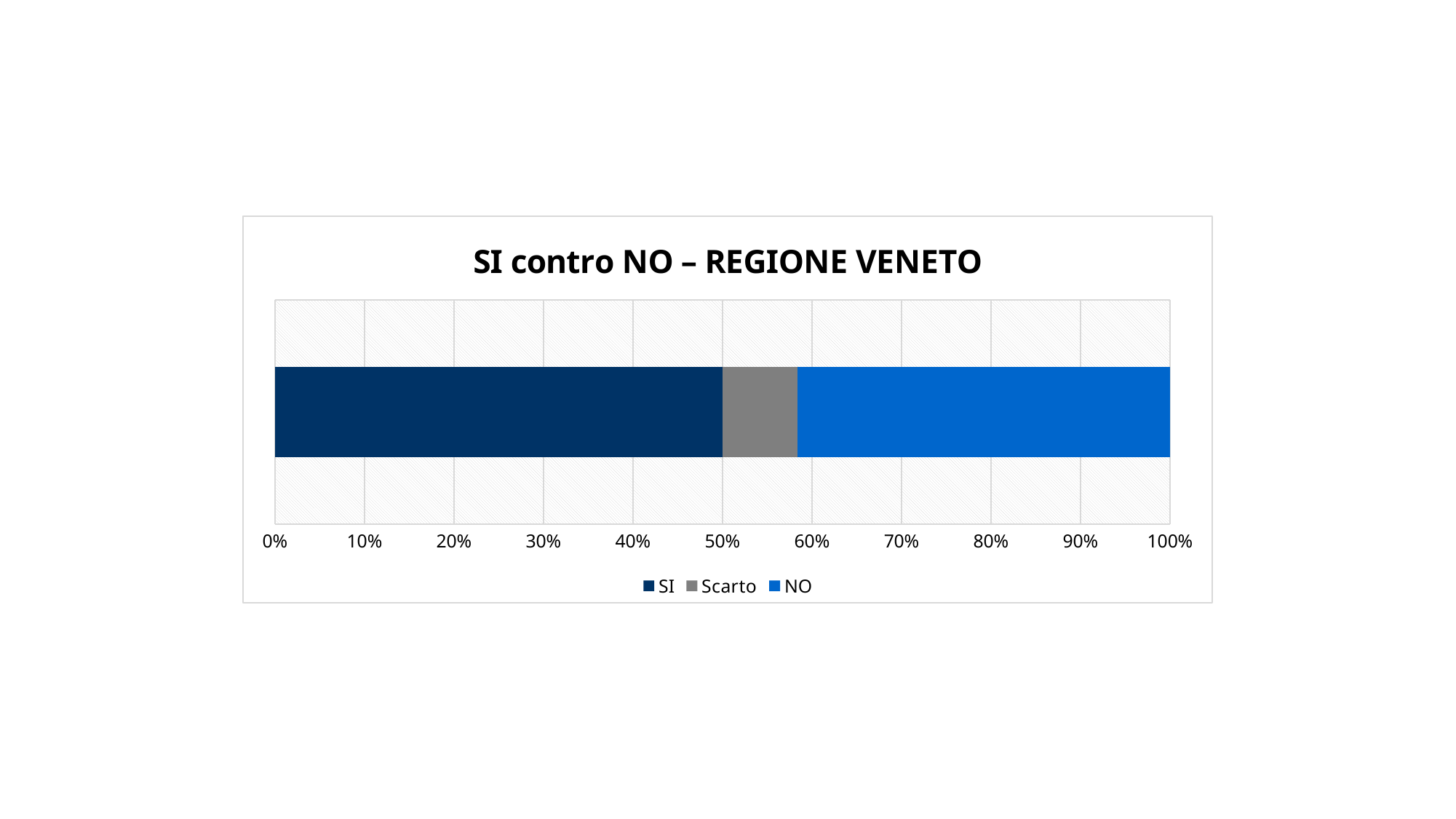
At which axis tick does the SI segment end? 50% Which is larger, the NO segment or the Scarto segment? NO Is the value for NO greater or less than 30%? greater How many series does the legend list? 3 What is the title of the chart? SI contro NO – REGIONE VENETO Which segment of the bar is the largest? SI Is the value for Scarto greater or less than 20%? less Which is larger, the SI segment or the Scarto segment? SI Which segment of the bar is the smallest? Scarto What kind of chart is shown on the slide? Stacked bar chart Is the value for SI greater or less than 40%? greater Which series are listed in the legend, in order? SI, Scarto, NO